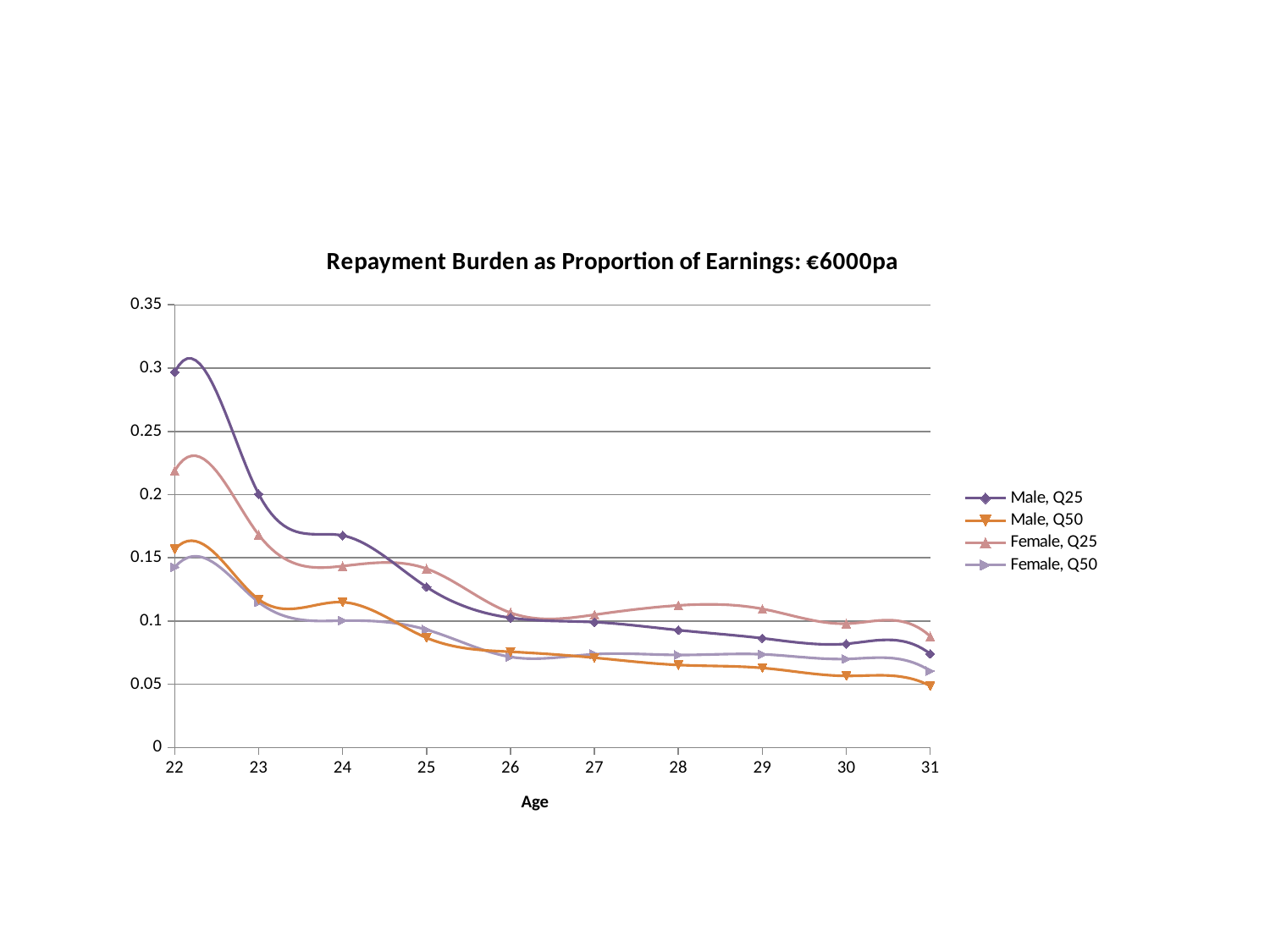
Do the values for the Male, Q25 series rise or fall as age increases from 22 to 31? Fall Is the value for Male, Q25 at age 24 greater or less than 0.15? greater Is the value for Male, Q50 at age 31 greater or less than 0.1? less What is the title of the chart? Repayment Burden as Proportion of Earnings: €6000pa Is the value for Male, Q25 at age 22 greater or less than 0.25? greater What is the label of the x axis? Age What kind of chart is shown on the slide? Line chart How many series does the legend list? 4 Which series has the highest value at age 22? Male, Q25 How many age points are plotted along the x axis? 10 At age 28, which is larger: the value for Female, Q25 or the value for Male, Q25? Female, Q25 Which series has the lowest value at age 31? Male, Q50